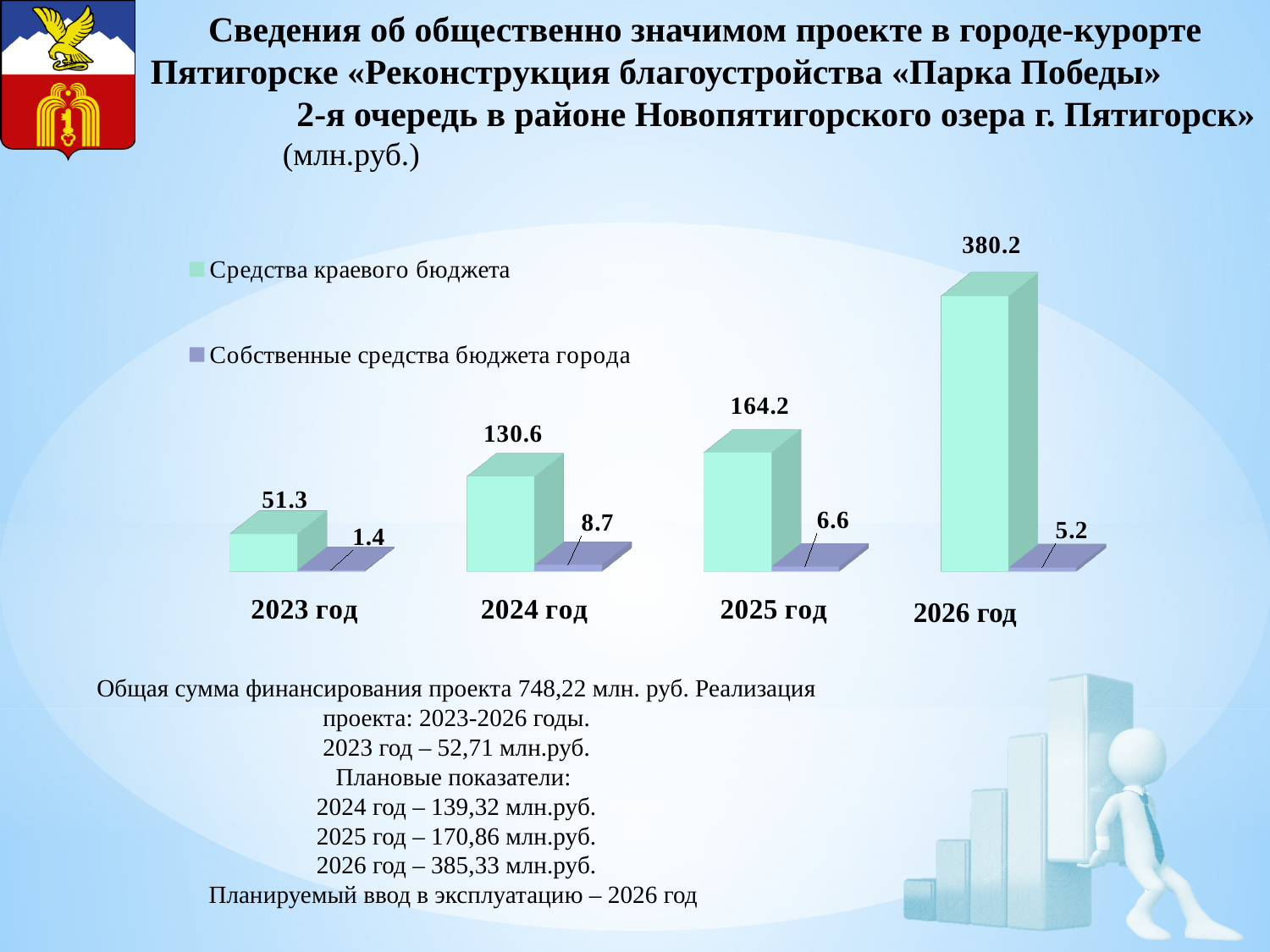
How many series does the legend list? 2 Which is larger: Собственные средства бюджета города in 2024 год or in 2026 год? 2024 год What is the difference between the Средства краевого бюджета values for 2025 год and 2024 год? 33.6 How many years are shown on the x axis of the chart? 4 In which year is the value for Собственные средства бюджета города the lowest? 2023 год What is the value for Собственные средства бюджета города in 2024 год? 8.7 Do the values for Средства краевого бюджета rise or fall from 2023 год to 2026 год? Rise What is the value for Средства краевого бюджета in 2026 год? 380.2 What is the value for Средства краевого бюджета in 2023 год? 51.3 In which year is the value for Средства краевого бюджета the highest? 2026 год What is the value for Собственные средства бюджета города in 2025 год? 6.6 What kind of chart is shown on the slide? Bar chart